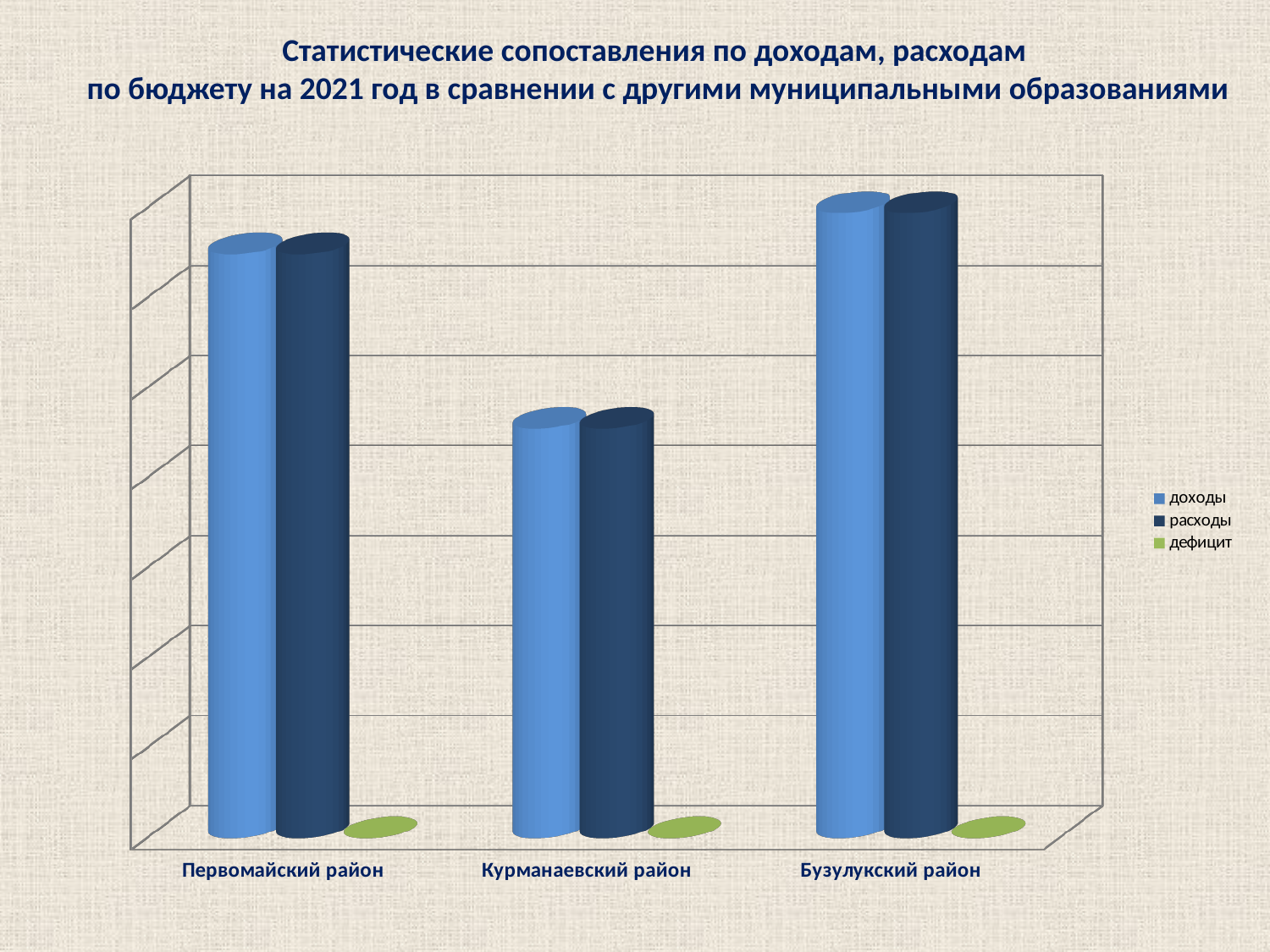
Which series is shown in light blue in the legend? доходы Which district has the lowest value for расходы? Курманаевский район Which district has the highest value for доходы? Бузулукский район How many municipal districts (categories) are shown on the x axis? 3 What kind of chart is shown on the slide? bar chart Which district has the lowest value for доходы? Курманаевский район Which series is shown in green in the legend? дефицит Which district has the highest value for расходы? Бузулукский район Which is larger: расходы for Бузулукский район or расходы for Первомайский район? Бузулукский район Which is larger: доходы for Первомайский район or доходы for Курманаевский район? Первомайский район How many series does the legend list? 3